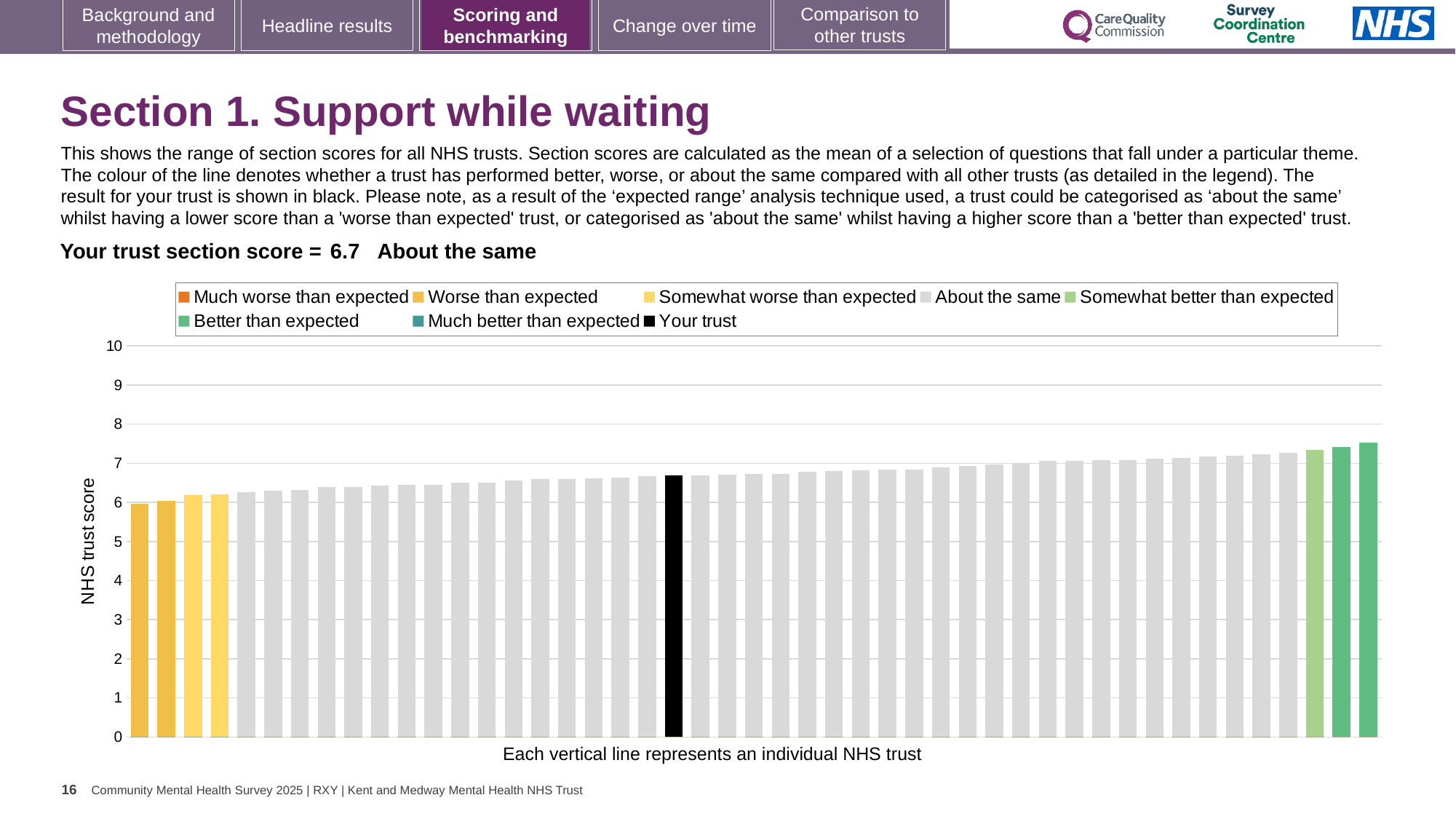
Is the value of the tallest bar (rightmost trust) greater or less than 7? greater Which category is your trust placed in according to the text above the chart? About the same Is the value of the shortest bar (leftmost trust) greater or less than 7? less How many entries does the chart legend list? 8 What is the label on the y axis of the chart? NHS trust score How many bars are coloured as 'Somewhat better than expected' (light green)? 1 Is the value for your trust (the black bar) greater or less than 6? greater How many bars are coloured as 'Better than expected' (dark green)? 2 What kind of chart is shown on the slide? bar chart What colour is the bar representing your trust? black What is the section score for your trust shown on the slide? 6.7 Do the bar values rise or fall from left to right along the x axis? rise